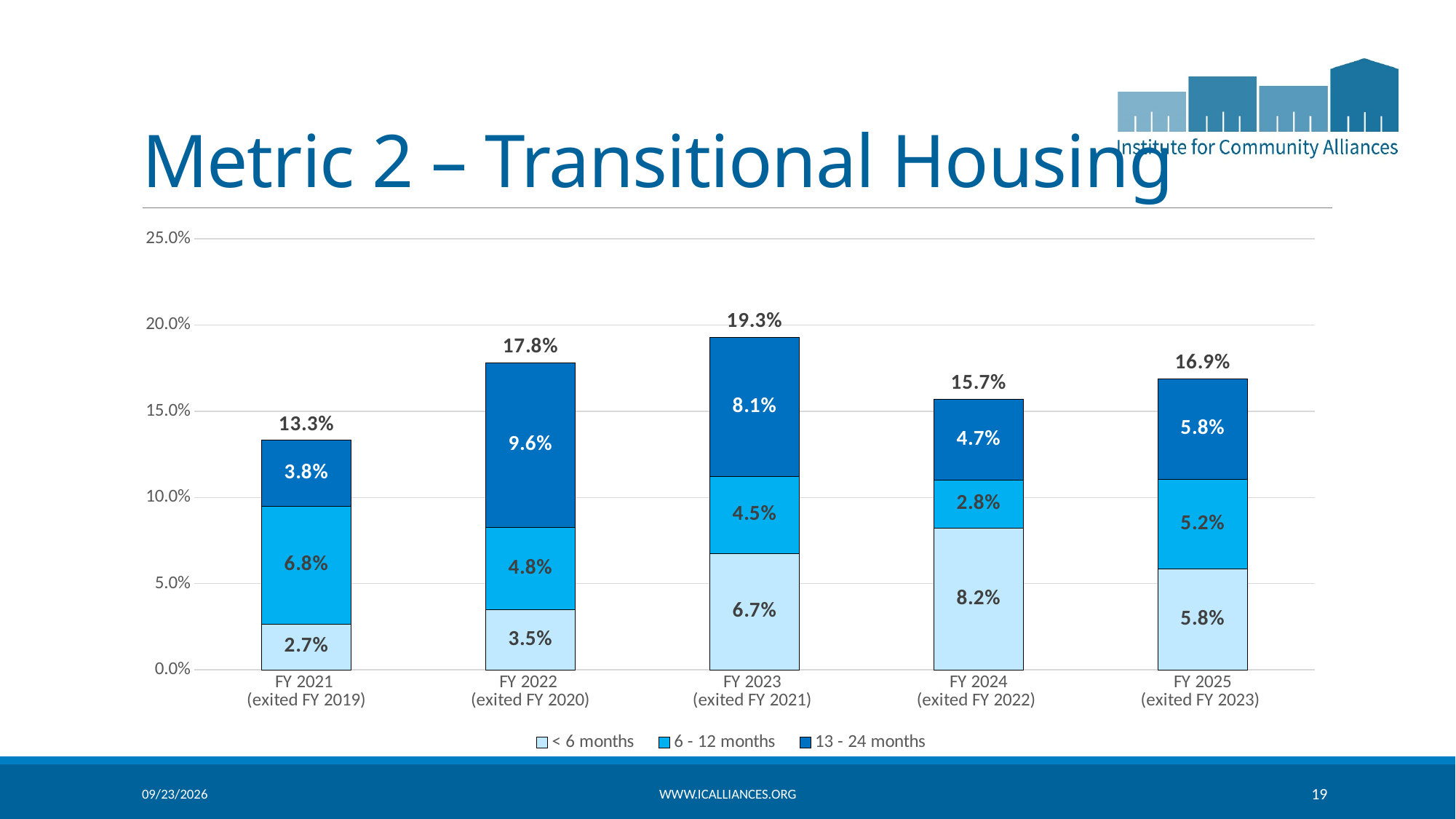
What is the difference between the stacked bar totals for FY 2022 (exited FY 2020) and FY 2021 (exited FY 2019)? 4.5% Which fiscal year has the lowest stacked bar total? FY 2021 (exited FY 2019) What is the value of the 13 - 24 months segment for FY 2022 (exited FY 2020)? 9.6% What is the value of the < 6 months segment for FY 2024 (exited FY 2022)? 8.2% Is the stacked bar total for FY 2024 (exited FY 2022) greater or less than 15.0%? greater What kind of chart is shown on the slide? Stacked bar chart What is the total of the stacked bar for FY 2023 (exited FY 2021)? 19.3% How many series does the legend list? 3 What is the value of the 6 - 12 months segment for FY 2021 (exited FY 2019)? 6.8% Which is larger: the 13 - 24 months segment for FY 2023 (exited FY 2021) or for FY 2025 (exited FY 2023)? FY 2023 (exited FY 2021) Which fiscal year has the highest stacked bar total? FY 2023 (exited FY 2021) How many fiscal year categories are shown on the x axis? 5